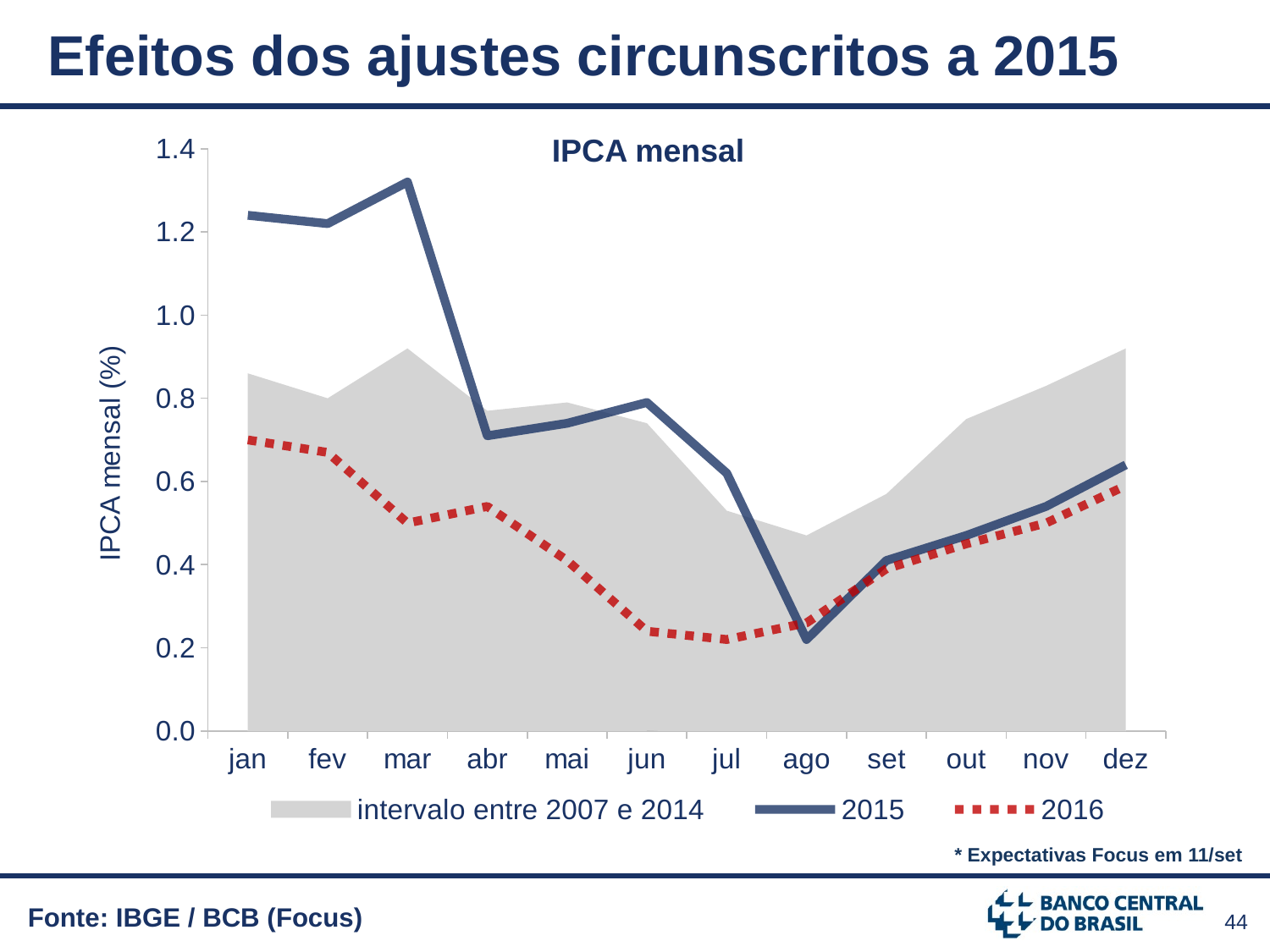
In which month does the 2015 series reach its lowest value? ago In jan, which series has the larger value, 2015 or 2016? 2015 Is the value for 2015 in ago greater or less than 0.4? less What is the title of the chart? IPCA mensal Is the value for 2015 in mar greater or less than 1.2? greater Is the value for 2016 in jul greater or less than 0.4? less How many series does the legend of the chart list? 3 In which month does the 2016 series reach its highest value? jan Does the 2015 series rise or fall from mar to ago? fall In which month does the 2015 series reach its highest value? mar How many months are shown on the x axis of the chart? 12 What kind of chart is shown on the slide? combination area and line chart